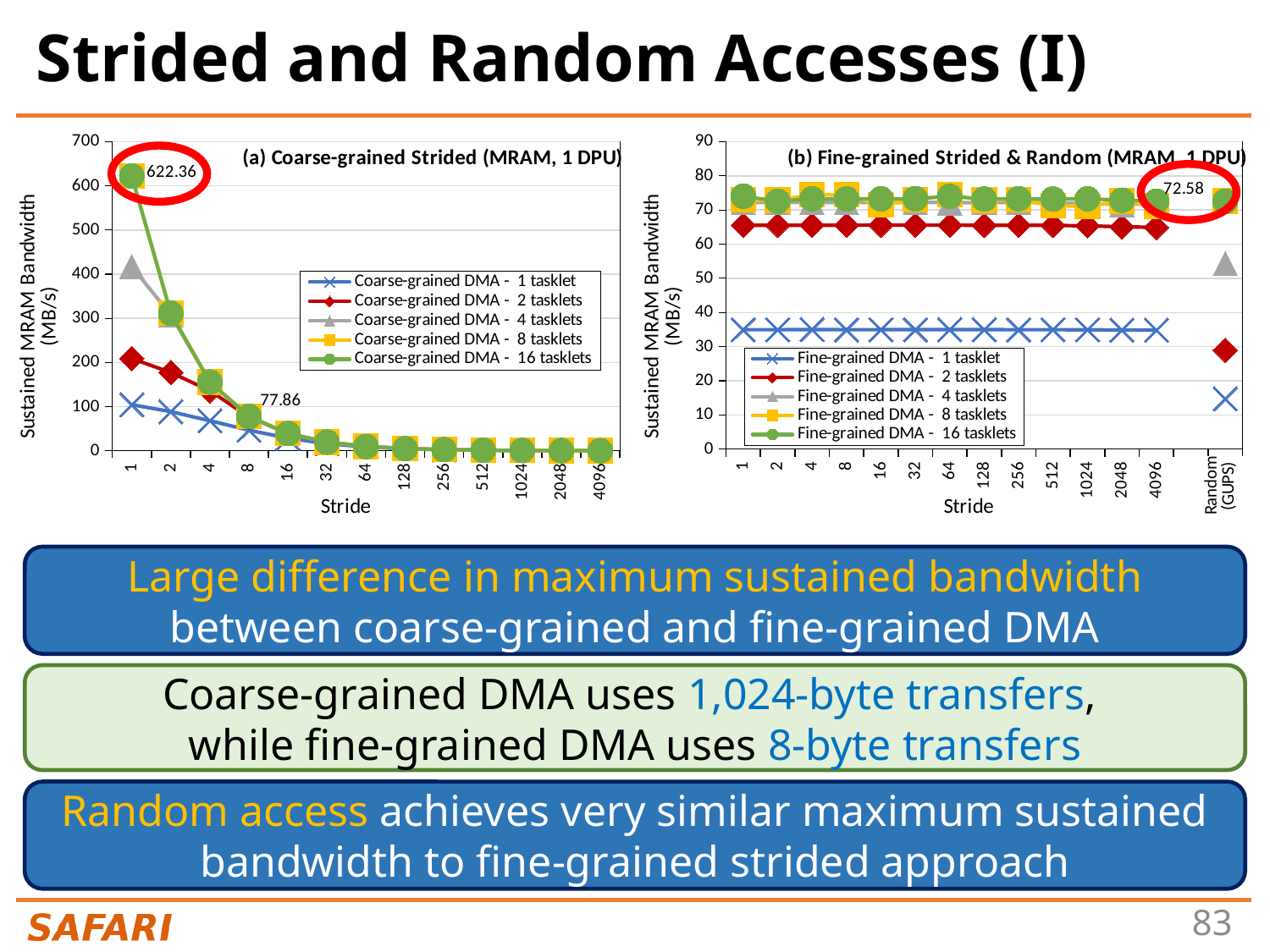
In chart (b) Fine-grained Strided & Random, is the value for Fine-grained DMA - 4 tasklets at Random (GUPS) greater or less than 50? greater In chart (b) Fine-grained Strided & Random, what is the circled data label value at Random (GUPS)? 72.58 In chart (b) Fine-grained Strided & Random, is the value for Fine-grained DMA - 1 tasklet at stride 1 greater or less than 40? less In chart (b) Fine-grained Strided & Random, at Random (GUPS), which is larger: Fine-grained DMA - 1 tasklet or Fine-grained DMA - 2 tasklets? Fine-grained DMA - 2 tasklets In chart (a) Coarse-grained Strided, besides 622.36, what other value is printed as a data label? 77.86 In chart (a) Coarse-grained Strided, at which stride is the sustained MRAM bandwidth highest? 1 What kind of chart is chart (a) Coarse-grained Strided (MRAM, 1 DPU)? line chart How many series does the legend of chart (b) Fine-grained Strided & Random (MRAM, 1 DPU) list? 5 How many categories are shown on the x axis of chart (b) Fine-grained Strided & Random, including Random (GUPS)? 14 In chart (a) Coarse-grained Strided, do the bandwidth values rise or fall as the stride increases? fall In chart (a) Coarse-grained Strided, what is the circled data label value at stride 1? 622.36 How many stride values are shown on the x axis of chart (a) Coarse-grained Strided? 13